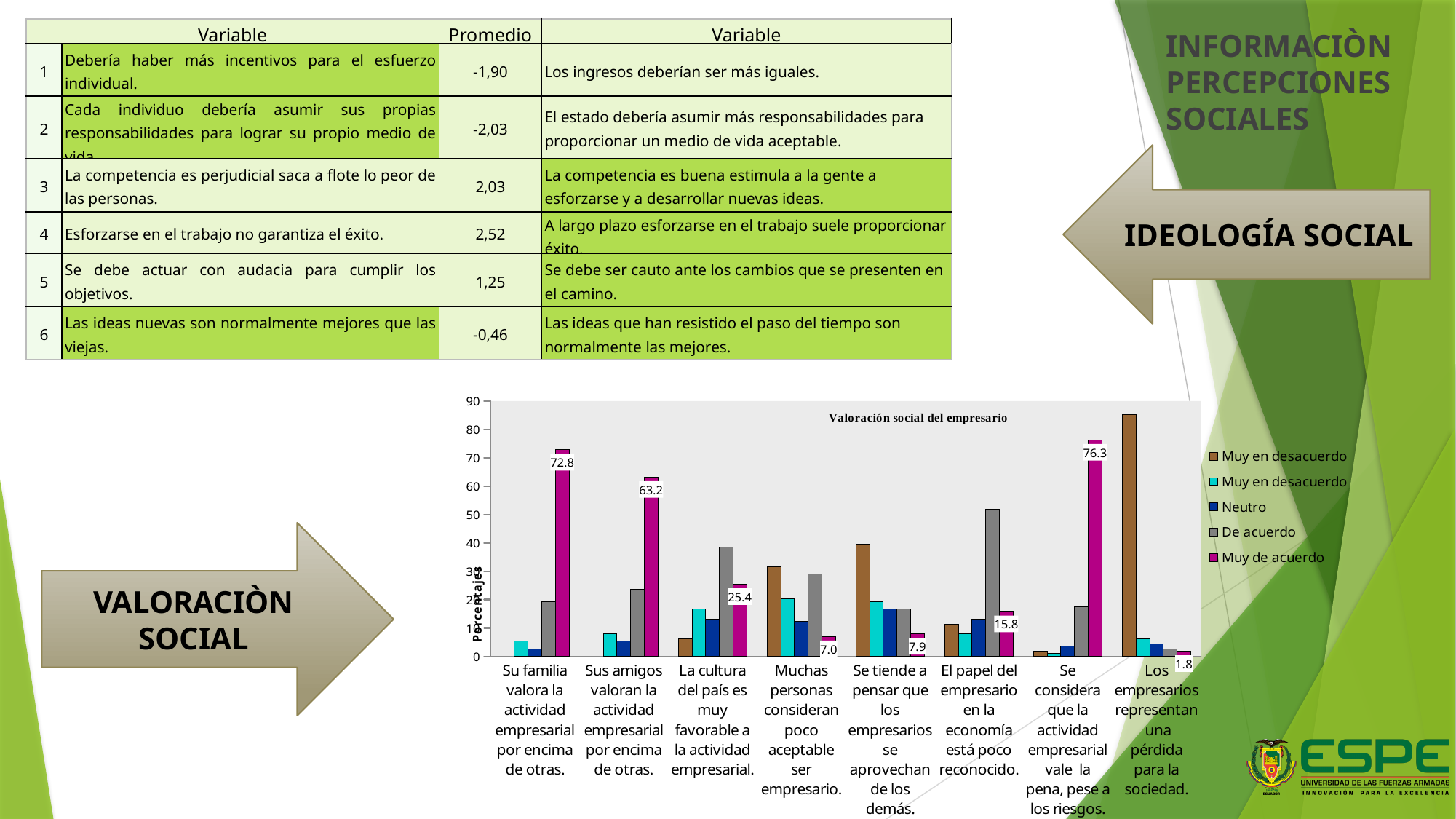
What type of chart is shown on the slide? bar chart How many series does the chart legend list? 5 What is the 'Muy de acuerdo' value for 'El papel del empresario en la economía está poco reconocido.'? 15.8 What is the difference between the 'Muy de acuerdo' values for 'Se considera que la actividad empresarial vale la pena, pese a los riesgos.' and 'Su familia valora la actividad empresarial por encima de otras.'? 3.5 Which is larger: the 'Muy de acuerdo' value for 'La cultura del país es muy favorable a la actividad empresarial.' or for 'Muchas personas consideran poco aceptable ser empresario.'? La cultura del país es muy favorable a la actividad empresarial. What is the 'Muy de acuerdo' value for 'Su familia valora la actividad empresarial por encima de otras.'? 72.8 What is the 'Muy de acuerdo' value for 'Sus amigos valoran la actividad empresarial por encima de otras.'? 63.2 Which category has the lowest 'Muy de acuerdo' value? Los empresarios representan una pérdida para la sociedad. How many categories are shown along the x axis of the chart? 8 Which category has the highest 'Muy de acuerdo' value? Se considera que la actividad empresarial vale la pena, pese a los riesgos. What is the title of the chart on the slide? Valoración social del empresario Is the first 'Muy en desacuerdo' value for 'Los empresarios representan una pérdida para la sociedad.' greater or less than 80? greater